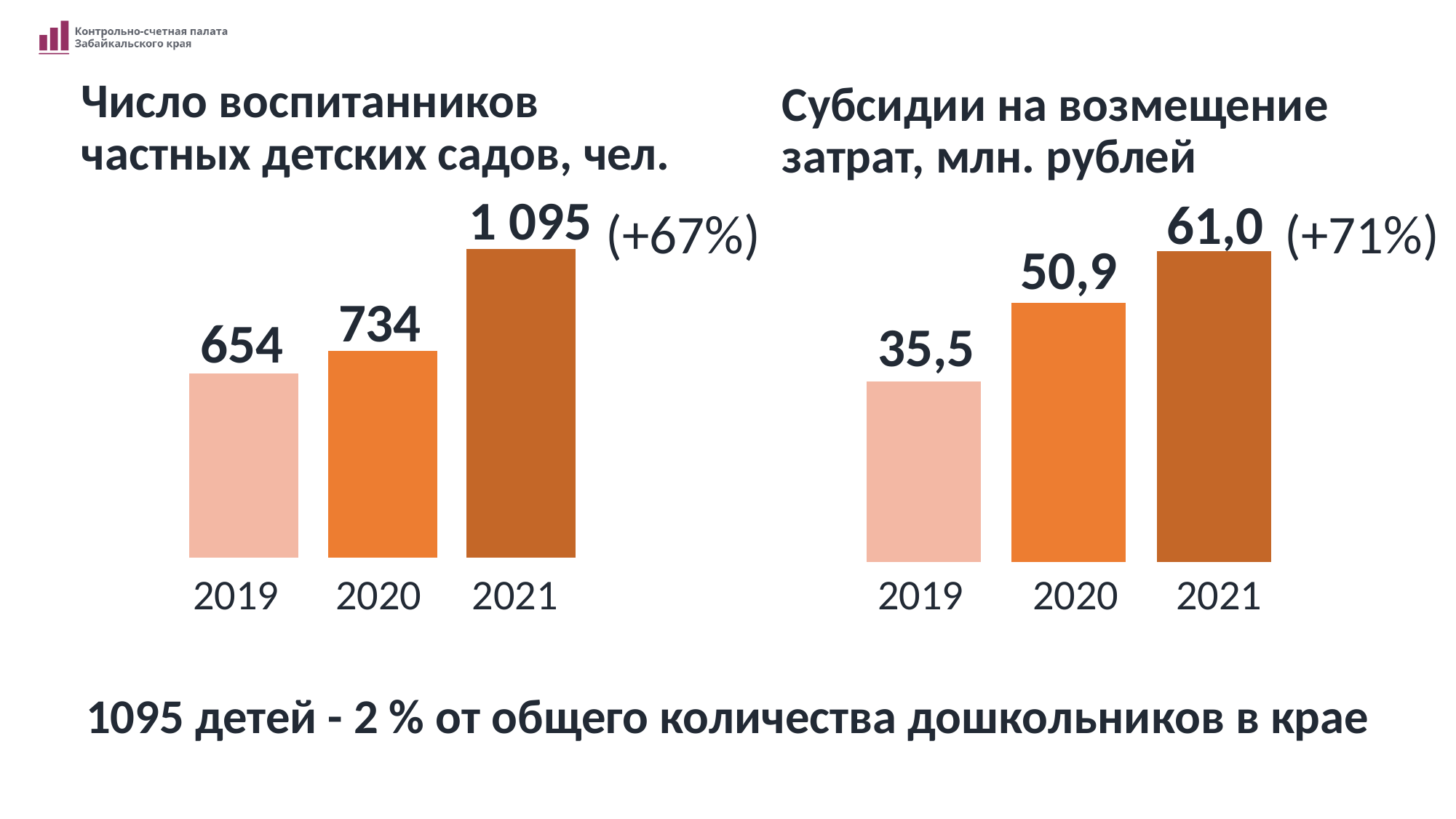
In the right chart (Субсидии на возмещение затрат, млн. рублей), which year has the lowest value? 2019 In the right chart (Субсидии на возмещение затрат, млн. рублей), what is the difference between the values for 2021 and 2020? 10,1 In the left chart (Число воспитанников частных детских садов, чел.), what is the value for 2021? 1 095 In the left chart (Число воспитанников частных детских садов, чел.), which year has the highest value? 2021 In the right chart (Субсидии на возмещение затрат, млн. рублей), what is the value for 2019? 35,5 In the left chart (Число воспитанников частных детских садов, чел.), do the values rise or fall from 2019 to 2021? Rise In the left chart (Число воспитанников частных детских садов, чел.), what is the difference between the values for 2020 and 2019? 80 In the right chart (Субсидии на возмещение затрат, млн. рублей), what is the value for 2020? 50,9 In the right chart (Субсидии на возмещение затрат, млн. рублей), which is larger, the value for 2020 or the value for 2019? 2020 In the left chart (Число воспитанников частных детских садов, чел.), what is the value for 2019? 654 How many bars are in the left chart (Число воспитанников частных детских садов, чел.)? 3 What kind of chart is the right chart (Субсидии на возмещение затрат, млн. рублей)? Bar chart